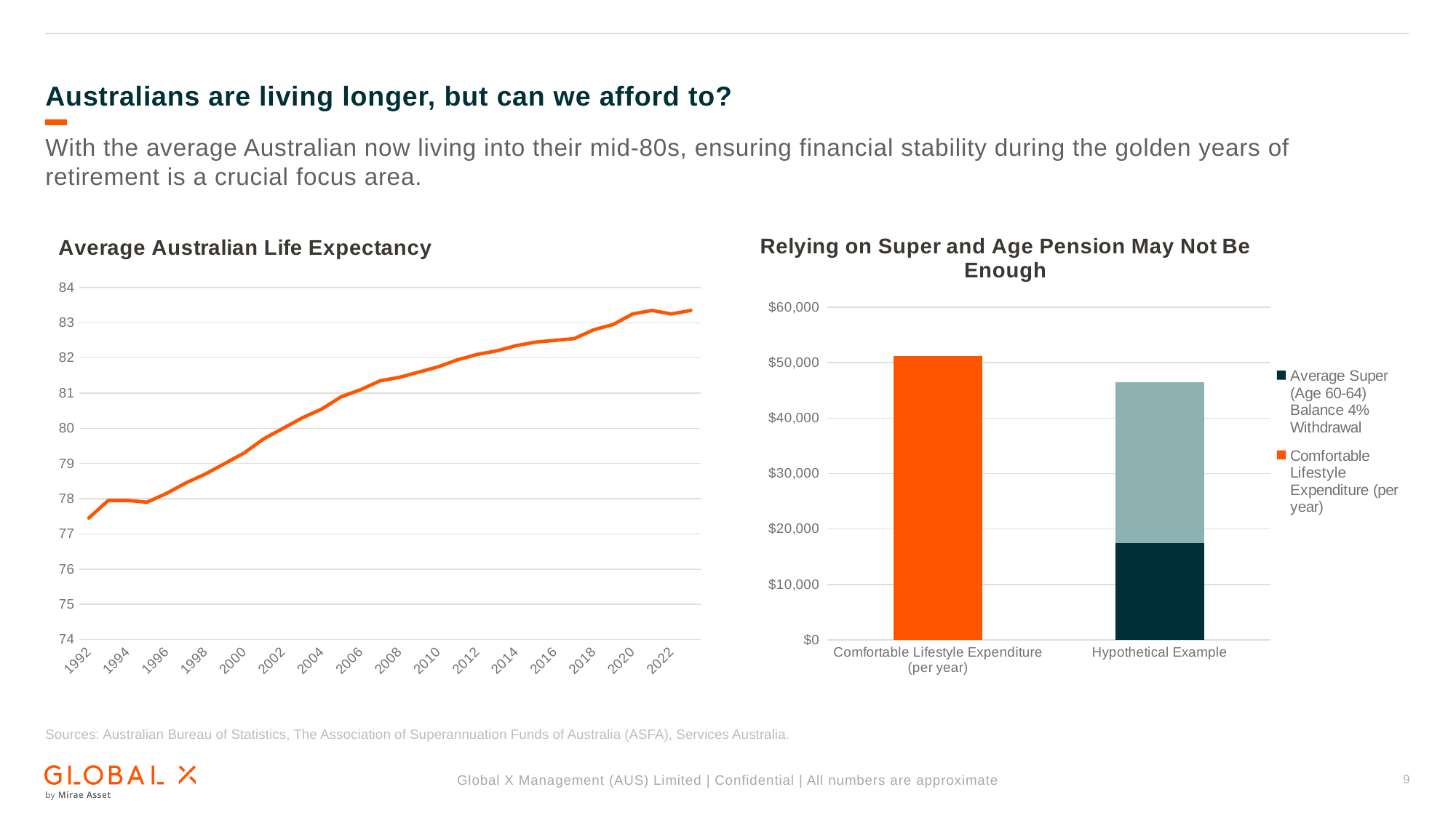
In the 'Relying on Super and Age Pension May Not Be Enough' chart, how many series does the legend list? 2 In the 'Average Australian Life Expectancy' chart, is the value for 1992 greater or less than 78? less What kind of chart is the 'Average Australian Life Expectancy' chart? line chart In the 'Relying on Super and Age Pension May Not Be Enough' chart, which bar is taller: Comfortable Lifestyle Expenditure (per year) or Hypothetical Example? Comfortable Lifestyle Expenditure (per year) In the 'Average Australian Life Expectancy' chart, does life expectancy generally rise or fall from 1992 to 2022? rise In the 'Relying on Super and Age Pension May Not Be Enough' chart, is the Comfortable Lifestyle Expenditure (per year) bar greater or less than $50,000? greater In the 'Average Australian Life Expectancy' chart, is the value for 2022 greater or less than 83? greater In the 'Average Australian Life Expectancy' chart, which year has the lowest life expectancy? 1992 What kind of chart is the 'Relying on Super and Age Pension May Not Be Enough' chart? bar chart In the 'Relying on Super and Age Pension May Not Be Enough' chart, how many categories are shown on the x axis? 2 In the 'Relying on Super and Age Pension May Not Be Enough' chart, what colour is the Comfortable Lifestyle Expenditure (per year) series? orange